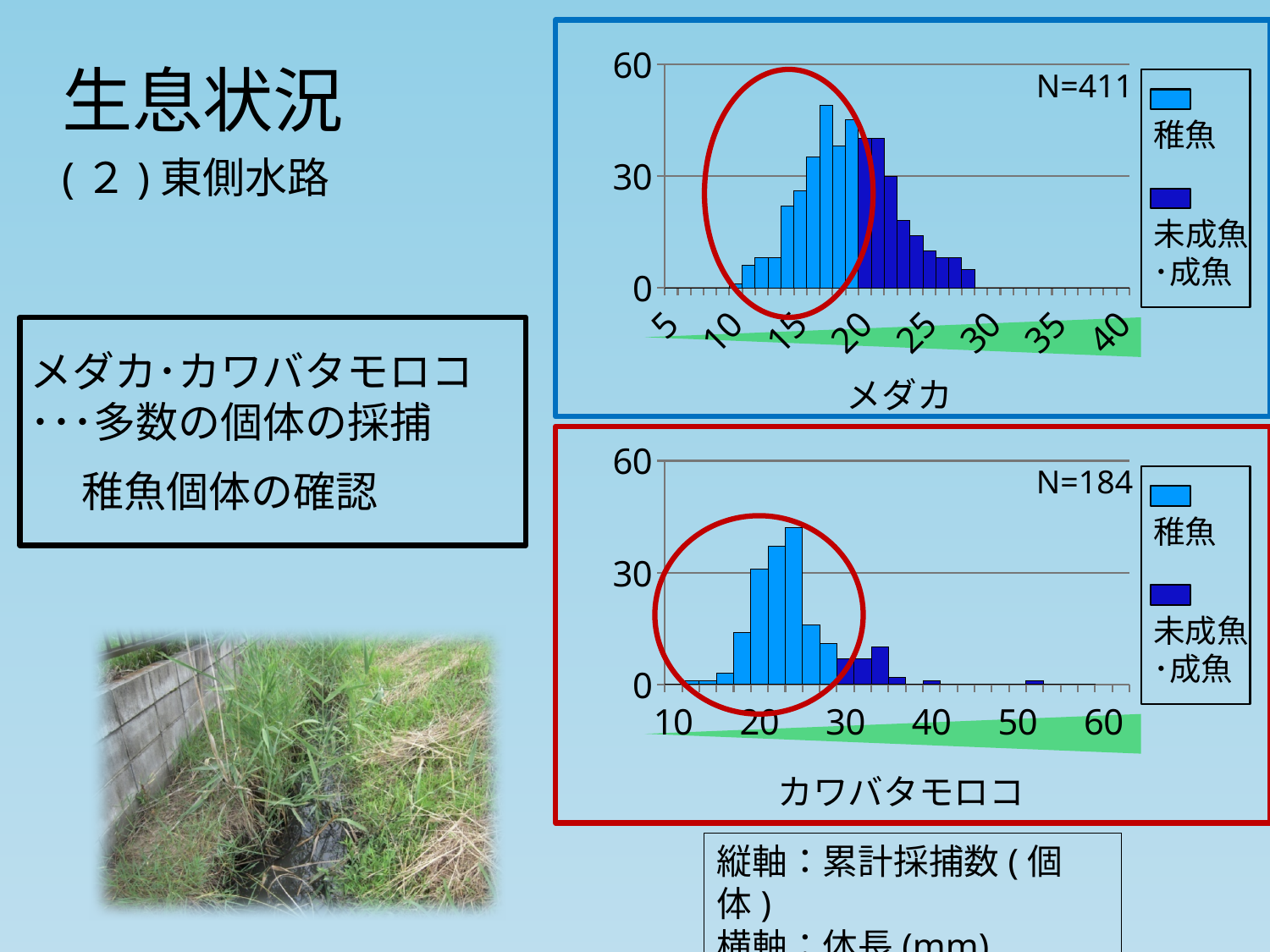
In the カワバタモロコ chart, which series contains the tallest bar, 稚魚 or 未成魚・成魚? 稚魚 Which chart has the larger printed N, メダカ or カワバタモロコ? メダカ What kind of chart is the メダカ chart at the top right of the slide? bar chart What sample size (N) is printed on the カワバタモロコ chart? N=184 What sample size (N) is printed on the メダカ chart? N=411 In the カワバタモロコ chart, are the bars around 40 mm greater or less than 30? less What is the difference between the N printed on the メダカ chart and the N printed on the カワバタモロコ chart? 227 What is the highest value shown on the vertical axis of the メダカ chart? 60 In the カワバタモロコ chart, is the tallest bar greater or less than 30? greater In the メダカ chart, is the tallest bar greater or less than 30? greater How many series does the legend of the カワバタモロコ chart list? 2 In the メダカ chart, which series contains the tallest bar, 稚魚 or 未成魚・成魚? 稚魚